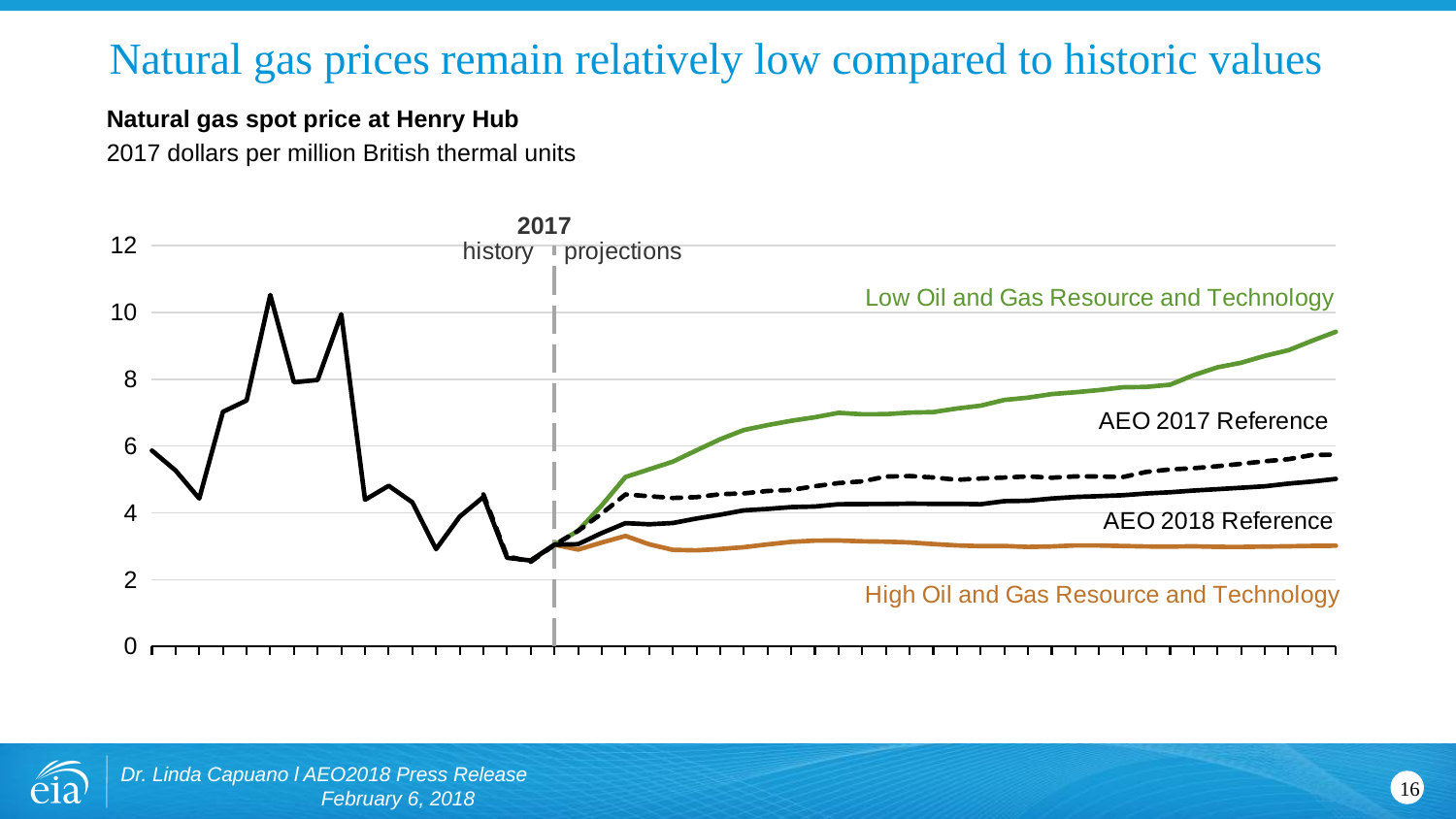
At the end of the projection period, is the value for AEO 2018 Reference greater or less than 6? less At the end of the projection period, is the value for High Oil and Gas Resource and Technology greater or less than 4? less What year separates the history and projections sections of the chart? 2017 At the end of the projection period, which is larger: AEO 2017 Reference or AEO 2018 Reference? AEO 2017 Reference Is the highest historical peak on the chart greater or less than 10? greater Does the Low Oil and Gas Resource and Technology line rise or fall over the projection period? rise Which projection series has the highest value at the end of the projection period? Low Oil and Gas Resource and Technology What kind of chart is shown on the slide? line chart How many projection series are labeled on the chart? 4 What is the title of the chart? Natural gas spot price at Henry Hub Which projection series has the lowest value at the end of the projection period? High Oil and Gas Resource and Technology